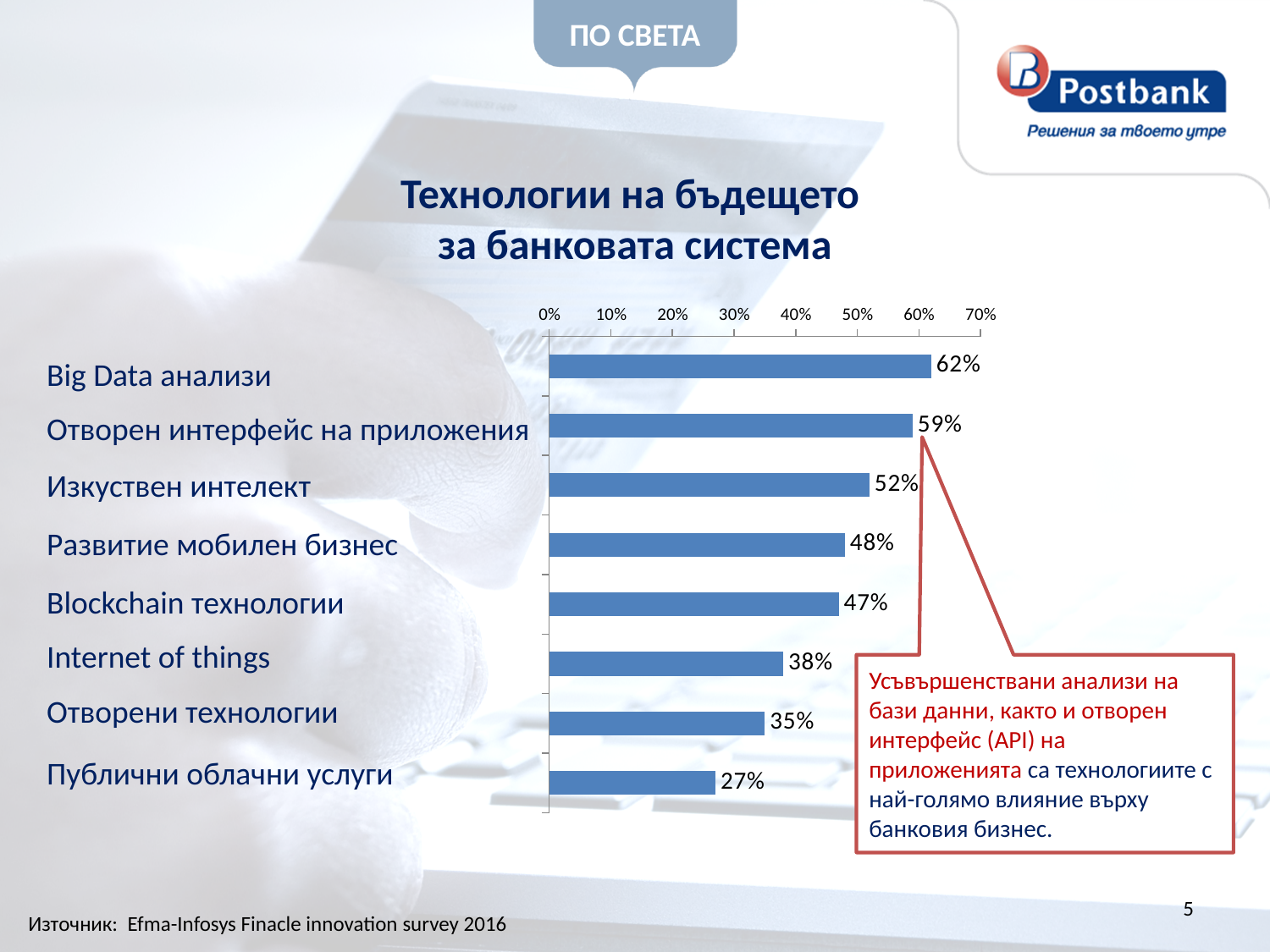
What is the source cited at the bottom of the slide? Efma-Infosys Finacle innovation survey 2016 What kind of chart is shown on the slide? bar chart What is the value for Big Data анализи? 62% How many categories are shown in the chart? 8 What is the value for Публични облачни услуги? 27% Is the value for Развитие мобилен бизнес greater or less than 40%? greater What is the difference between the values for Big Data анализи and Отворен интерфейс на приложения? 3% Which is larger, the value for Internet of things or the value for Отворени технологии? Internet of things What is the difference between the values for Изкуствен интелект and Публични облачни услуги? 25% Which category has the highest value? Big Data анализи What is the value for Blockchain технологии? 47% Which category has the lowest value? Публични облачни услуги